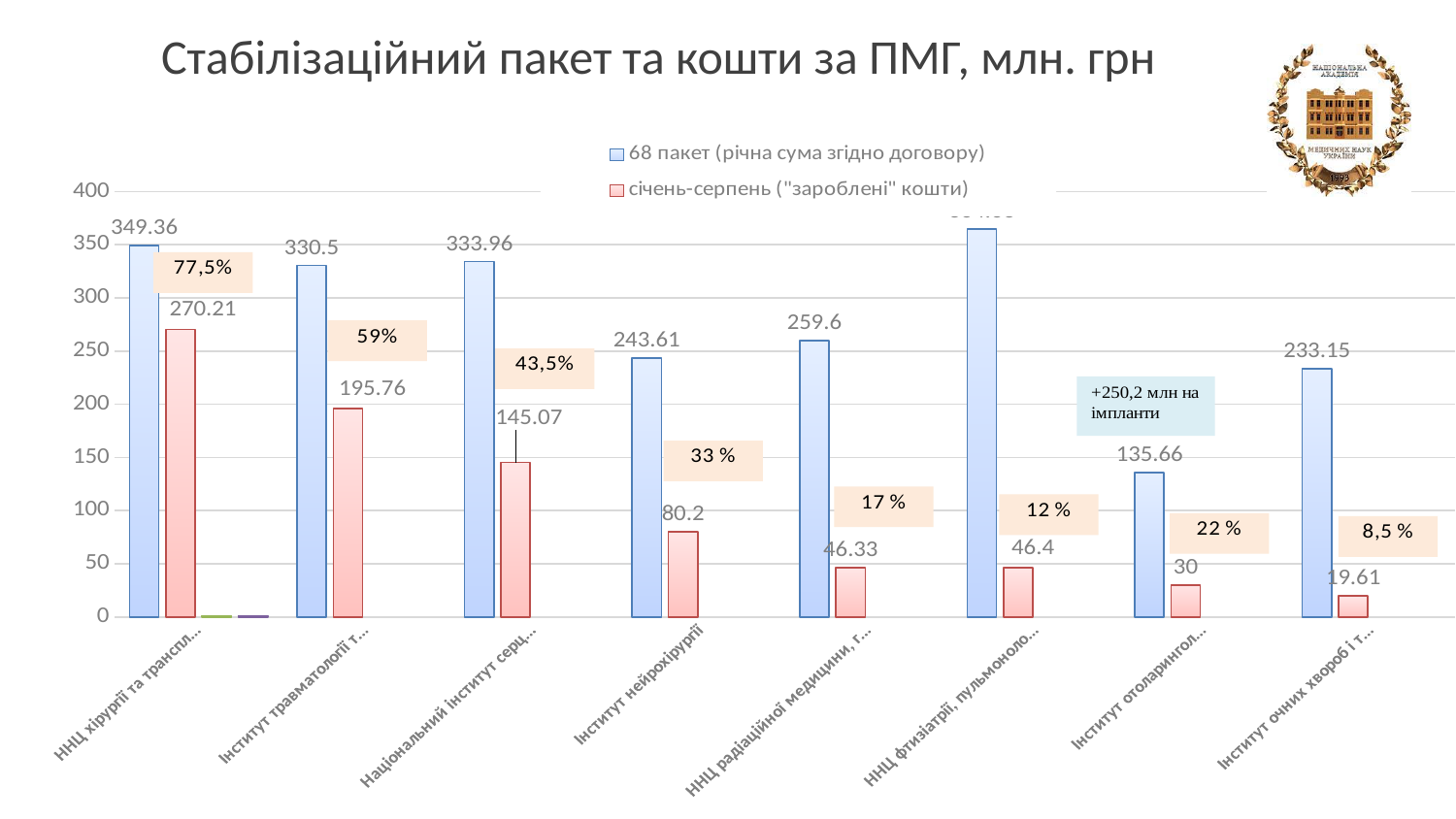
What is the value of the "68 пакет (річна сума згідно договору)" series for Інститут нейрохірургії? 243.61 How many institutes (categories) are shown on the x axis? 8 Which is larger: the "січень-серпень" value for Інститут травматології т... or for Національний інститут серц...? Інститут травматології т... How many series does the legend list? 2 What is the difference between the "68 пакет" value and the "січень-серпень" value for Інститут отоларингол...? 105.66 What is the value of the "січень-серпень ("зароблені" кошти)" series for Інститут нейрохірургії? 80.2 What is the value of the "січень-серпень" series for Інститут очних хвороб і т...? 19.61 What type of chart is shown on the slide? bar chart What is the value of the "68 пакет" series for ННЦ хірургії та транспл...? 349.36 Which institute has the highest value in the "січень-серпень ("зароблені" кошти)" series? ННЦ хірургії та транспл... Which institute has the lowest value in the "січень-серпень ("зароблені" кошти)" series? Інститут очних хвороб і т... Is the "68 пакет" value for ННЦ фтизіатрії, пульмоноло... greater or less than 300? greater